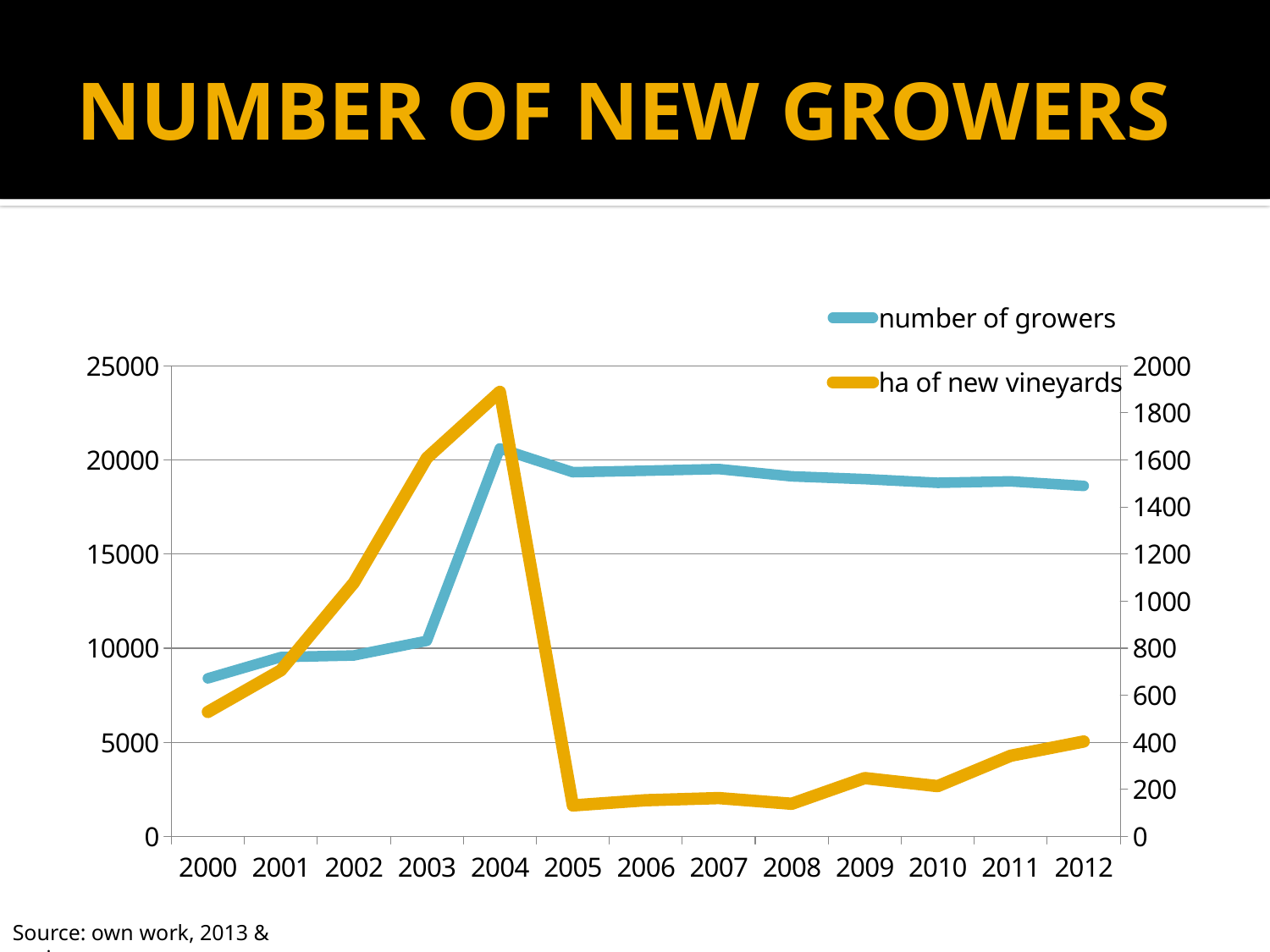
In which year is the number of growers at its lowest? 2000 How many years are plotted along the x axis? 13 Are the ha of new vineyards in 2005 greater or less than 200? less Which year has more ha of new vineyards, 2003 or 2012? 2003 Is the number of growers in 2000 greater or less than 10000? less What kind of chart is shown on the slide? line chart Is the number of growers in 2012 greater or less than 20000? less In which year does the number of growers reach its highest value? 2004 In which year do the ha of new vineyards reach their highest value? 2004 How many series does the legend list? 2 Do the ha of new vineyards rise or fall from 2000 to 2004? rise